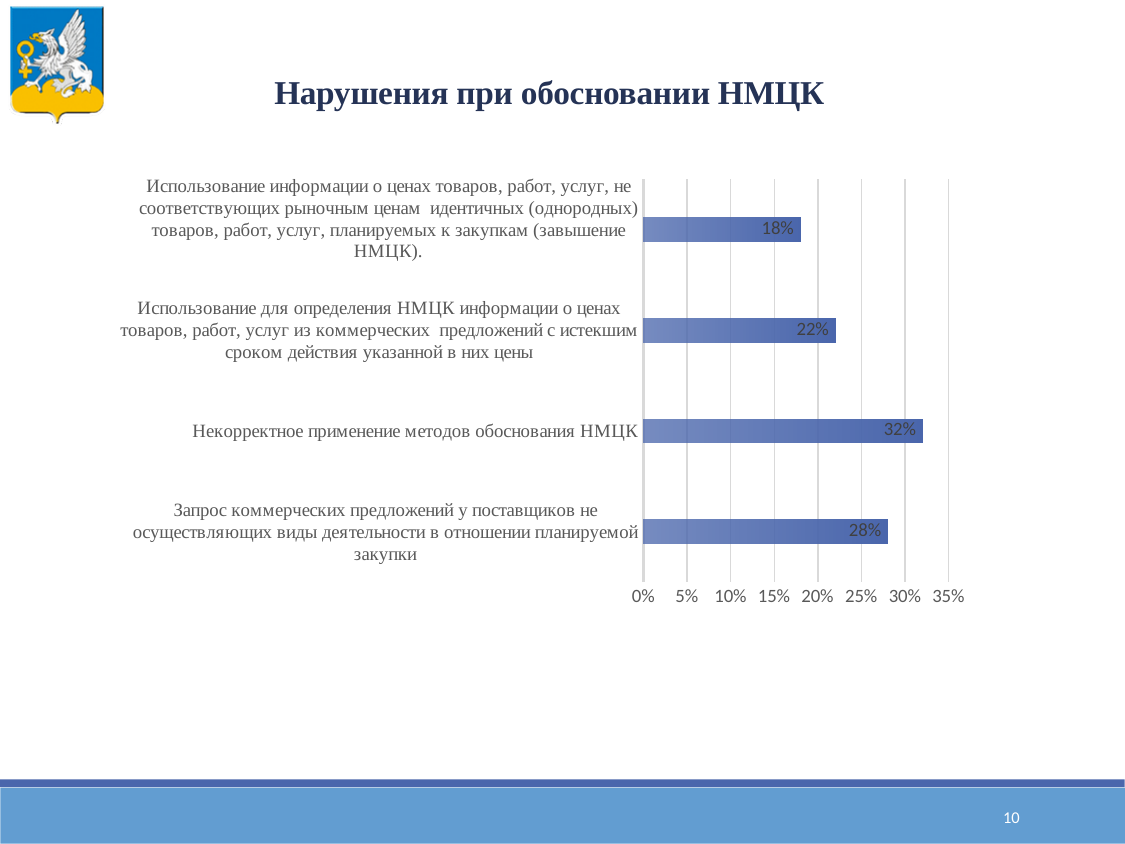
What kind of chart is shown on the slide? Bar chart Which category has the highest value? Некорректное применение методов обоснования НМЦК What is the title of the slide containing the chart? Нарушения при обосновании НМЦК What is the difference between the value for "Некорректное применение методов обоснования НМЦК" and the value for the category about commercial offers with an expired price validity period? 10% Which category has the lowest value? Использование информации о ценах товаров, работ, услуг, не соответствующих рыночным ценам идентичных (однородных) товаров, работ, услуг, планируемых к закупкам (завышение НМЦК). What is the value for the category about using price information not matching market prices ("завышение НМЦК")? 18% What is the value for "Некорректное применение методов обоснования НМЦК"? 32% Which is larger: the value for "Запрос коммерческих предложений у поставщиков не осуществляющих виды деятельности в отношении планируемой закупки" or the value for the category about "завышение НМЦК"? Запрос коммерческих предложений у поставщиков не осуществляющих виды деятельности в отношении планируемой закупки Is the value for "Некорректное применение методов обоснования НМЦК" greater or less than 30%? greater What is the value for the category about using commercial offers with an expired price validity period ("Использование для определения НМЦК информации о ценах ... с истекшим сроком действия указанной в них цены")? 22% What is the value for "Запрос коммерческих предложений у поставщиков не осуществляющих виды деятельности в отношении планируемой закупки"? 28% How many categories are shown in the chart? 4